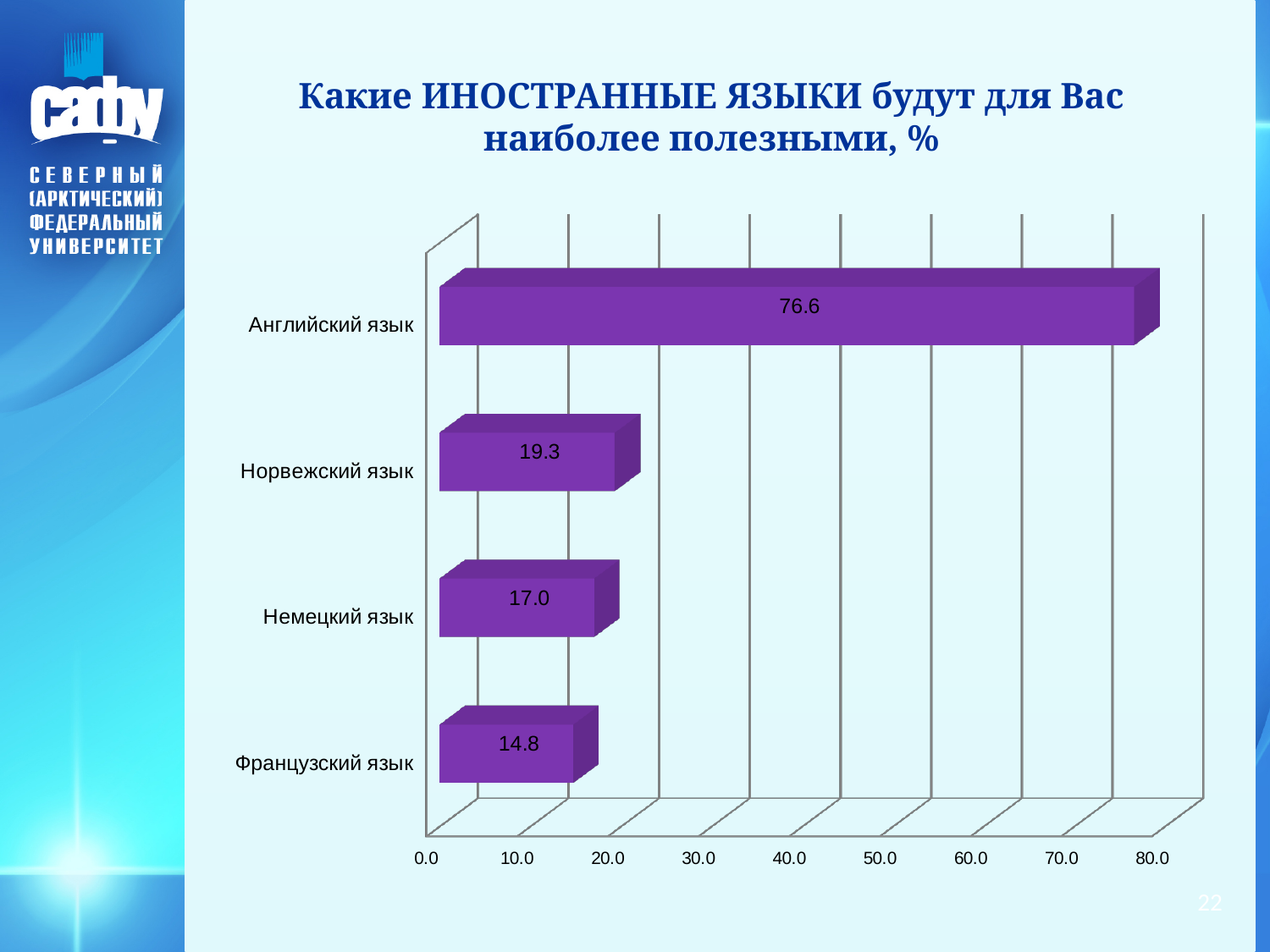
Which is larger, the value for Норвежский язык or Немецкий язык? Норвежский язык Which language has the highest value? Английский язык What is the value for Немецкий язык? 17.0 Which language has the lowest value? Французский язык What kind of chart is shown on the slide? Bar chart What is the value for Норвежский язык? 19.3 What is the value for Английский язык? 76.6 What is the difference between the values for Английский язык and Норвежский язык? 57.3 What is the value for Французский язык? 14.8 What is the difference between the values for Немецкий язык and Французский язык? 2.2 What is the title of the chart? Какие ИНОСТРАННЫЕ ЯЗЫКИ будут для Вас наиболее полезными, % How many languages are shown in the chart? 4